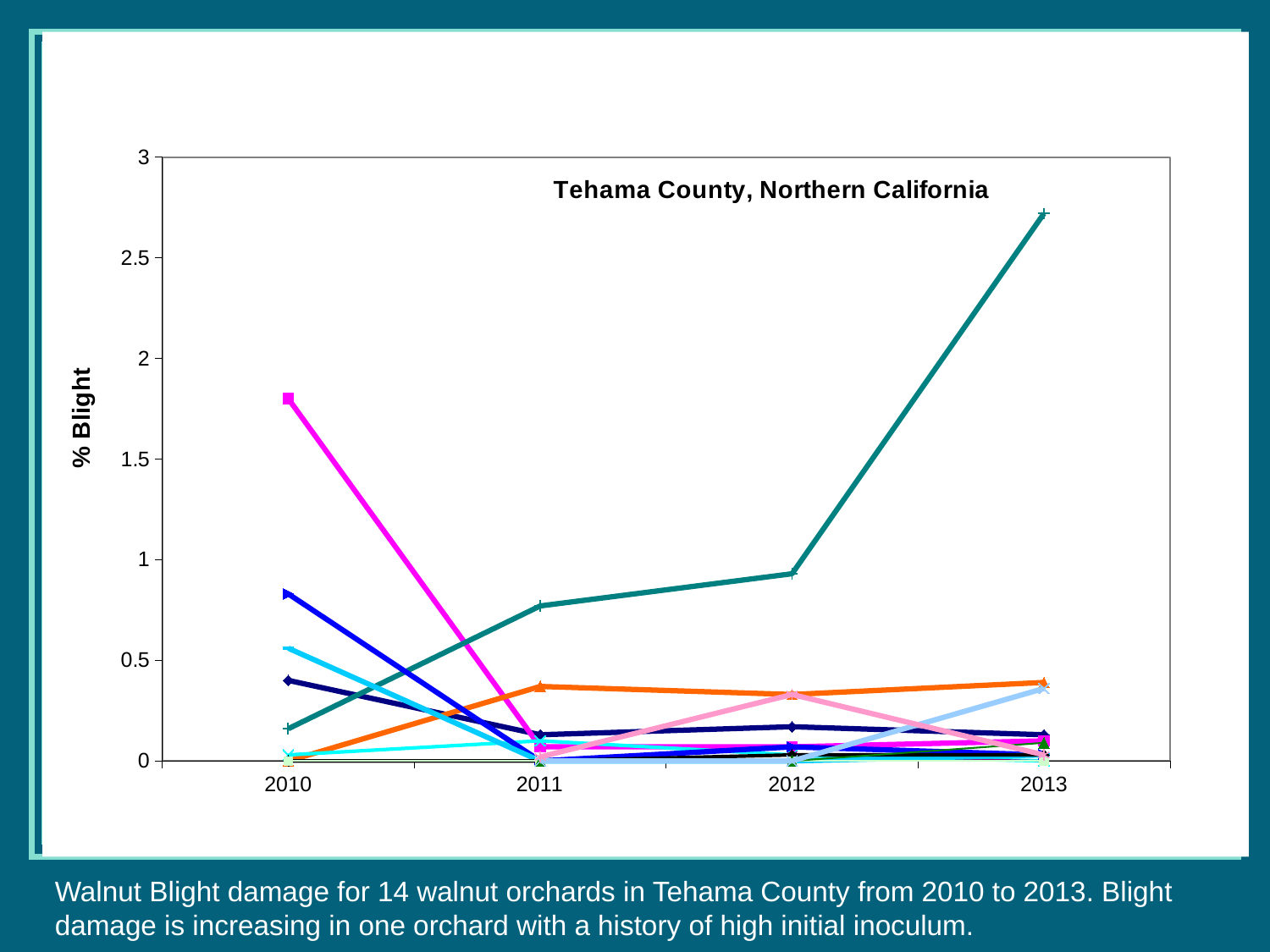
How many years are shown along the x axis of the chart? 4 Does the magenta line with square markers rise or fall from 2010 to 2011? fall Is the highest value plotted for 2011 greater or less than 1? less What is the maximum value shown on the vertical axis of the chart? 3 What is the title printed inside the chart? Tehama County, Northern California Is the highest value plotted for 2012 greater or less than 0.5? greater What is the label on the vertical axis of the chart? % Blight What kind of chart is shown on the slide? line chart In which year does the chart reach its highest plotted % Blight value? 2013 Does the dark teal line with plus markers rise or fall from 2010 to 2013? rise Is the highest value plotted for 2013 greater or less than 2.5? greater